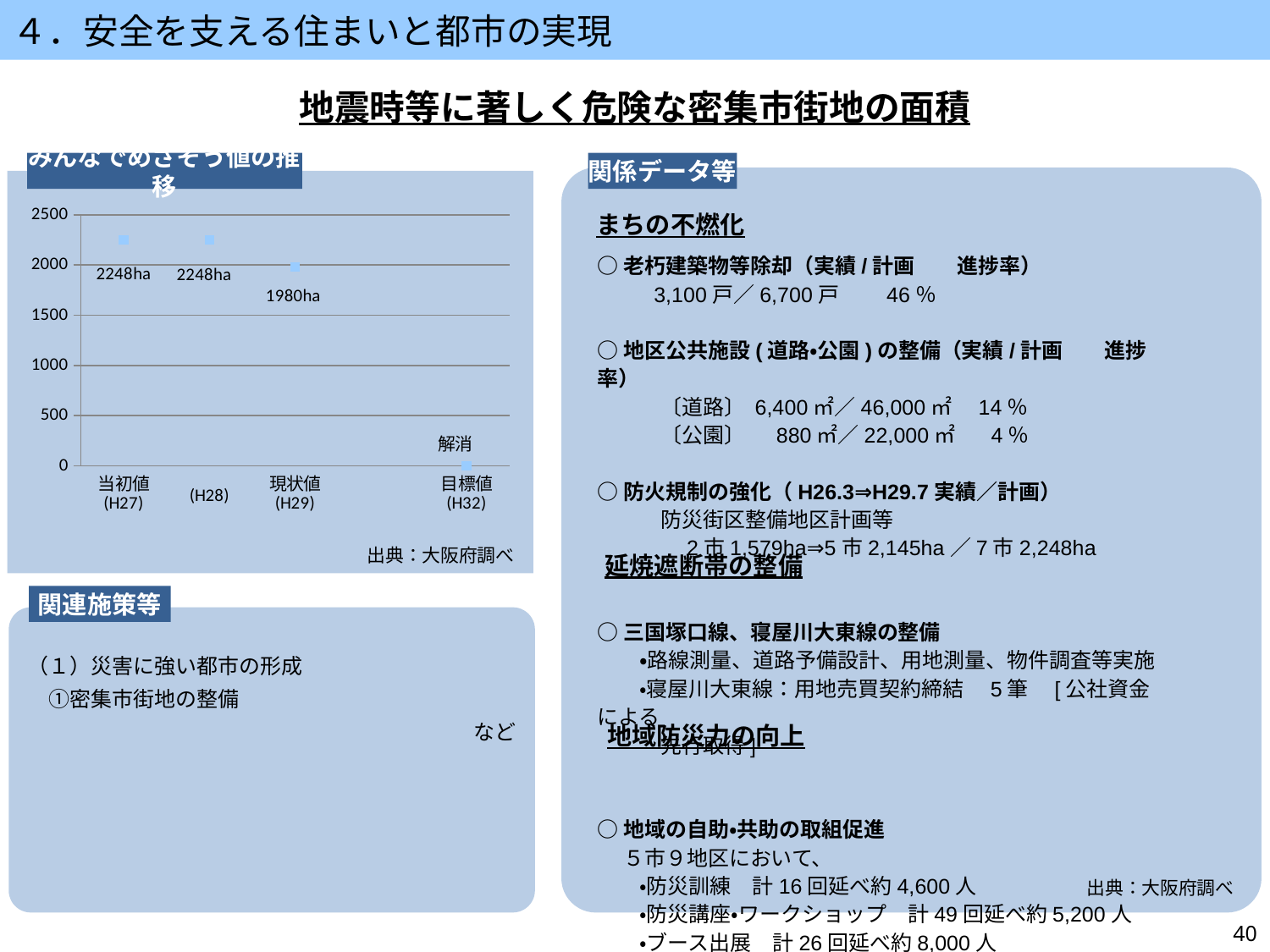
Is the value for 当初値(H27) greater or less than 2000? greater Which category has the lowest value in the chart? 目標値(H32) What is the value for 現状値(H29) in the chart? 1980ha What is the difference between the value for (H28) and the value for 現状値(H29)? 268ha How many categories are shown on the x axis of the chart? 4 What is the value for 当初値(H27) in the chart? 2248ha What label is shown for the 目標値(H32) point in the chart? 解消 What is the value plotted for (H28) in the chart? 2248ha Do the plotted values rise or fall from 当初値(H27) to 目標値(H32)? fall Is the value for 現状値(H29) greater or less than 2000? less Which is larger, the value for 当初値(H27) or the value for 現状値(H29)? 当初値(H27) What source is cited below the chart? 出典：大阪府調べ